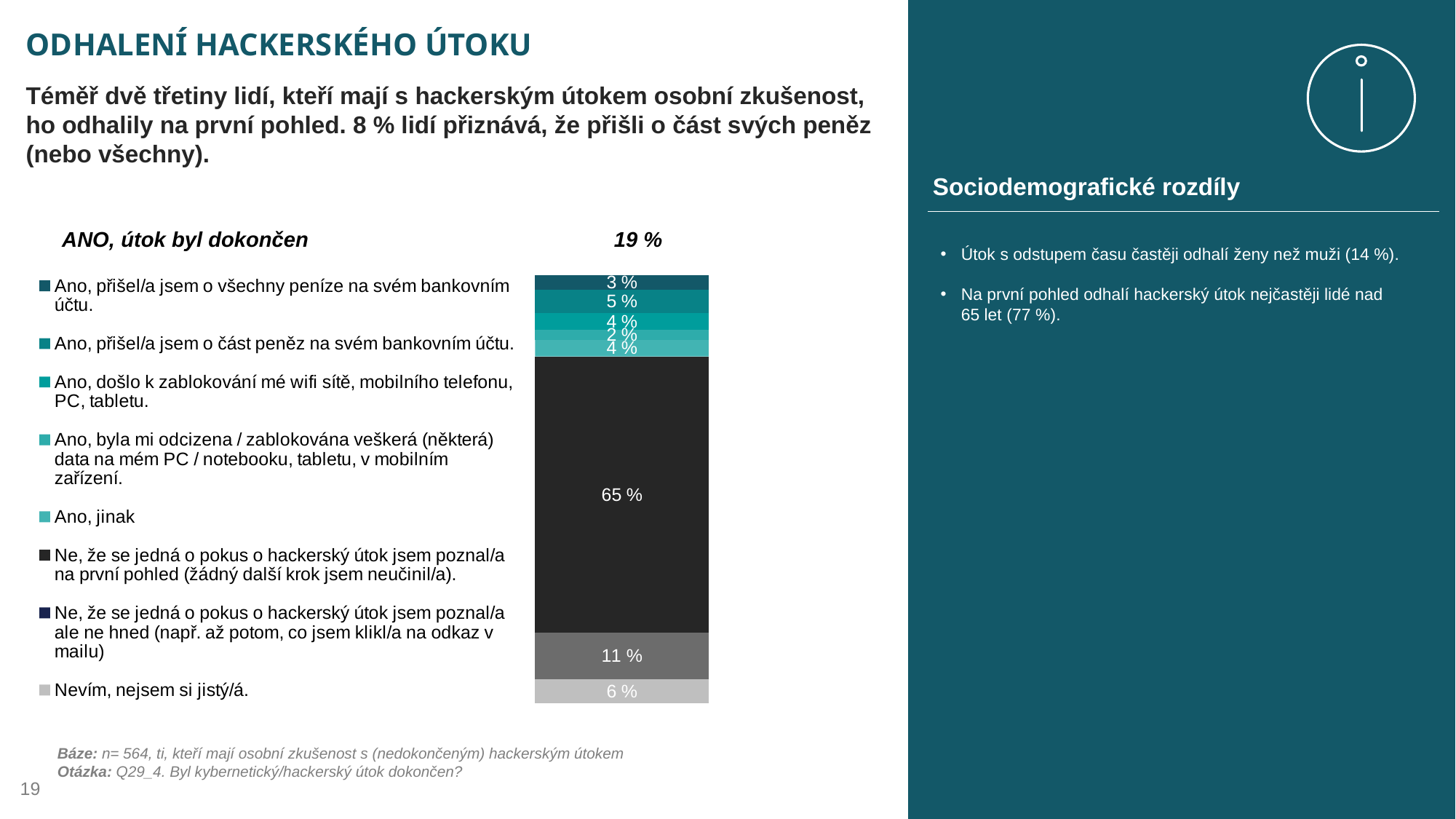
What is the difference between the value for "Ne, ... poznal/a na první pohled" (65 %) and "Ne, ... poznal/a ale ne hned" (11 %)? 54 % What kind of chart is shown on the slide? stacked bar chart How many entries does the chart legend list? 8 Which is larger: the value for "Nevím, nejsem si jistý/á." or the value for "Ano, přišel/a jsem o část peněz na svém bankovním účtu."? Nevím, nejsem si jistý/á. What is the value for "Ano, přišel/a jsem o část peněz na svém bankovním účtu."? 5 % What is the value for "Ne, že se jedná o pokus o hackerský útok jsem poznal/a na první pohled (žádný další krok jsem neučinil/a)."? 65 % What is the value for "Ano, přišel/a jsem o všechny peníze na svém bankovním účtu."? 3 % Which category has the highest value in the chart? Ne, že se jedná o pokus o hackerský útok jsem poznal/a na první pohled (žádný další krok jsem neučinil/a). What percentage is shown next to the label "ANO, útok byl dokončen" above the chart? 19 % What is the value for "Ne, že se jedná o pokus o hackerský útok jsem poznal/a ale ne hned (např. až potom, co jsem klikl/a na odkaz v mailu)"? 11 % Which category has the lowest value in the chart? Ano, byla mi odcizena / zablokována veškerá (některá) data na mém PC / notebooku, tabletu, v mobilním zařízení. What is the value for "Nevím, nejsem si jistý/á."? 6 %